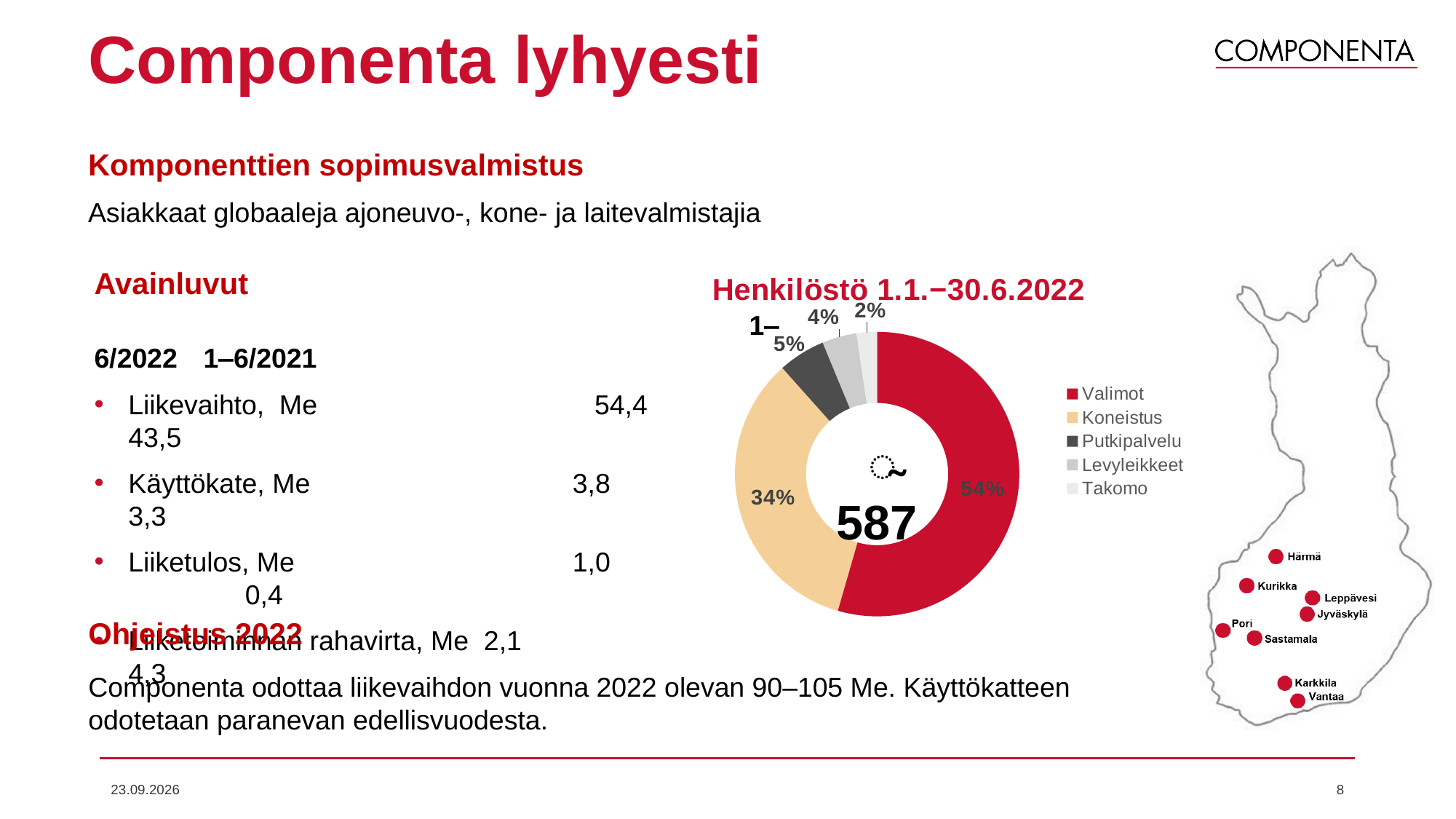
What share of the doughnut chart does Valimot represent? 54% What kind of chart is shown under the title "Henkilöstö 1.1.−30.6.2022"? Doughnut chart What is the title of the chart on the slide? Henkilöstö 1.1.−30.6.2022 Which category has the smallest share in the doughnut chart? Takomo What share of the doughnut chart does Takomo represent? 2% What share of the doughnut chart does Levyleikkeet represent? 4% What share of the doughnut chart does Putkipalvelu represent? 5% Which has a larger share in the doughnut chart, Putkipalvelu or Levyleikkeet? Putkipalvelu How many categories does the legend of the doughnut chart list? 5 Which category has the largest share in the doughnut chart? Valimot What is the difference in percentage points between the Valimot and Koneistus shares? 20 percentage points What share of the doughnut chart does Koneistus represent? 34%